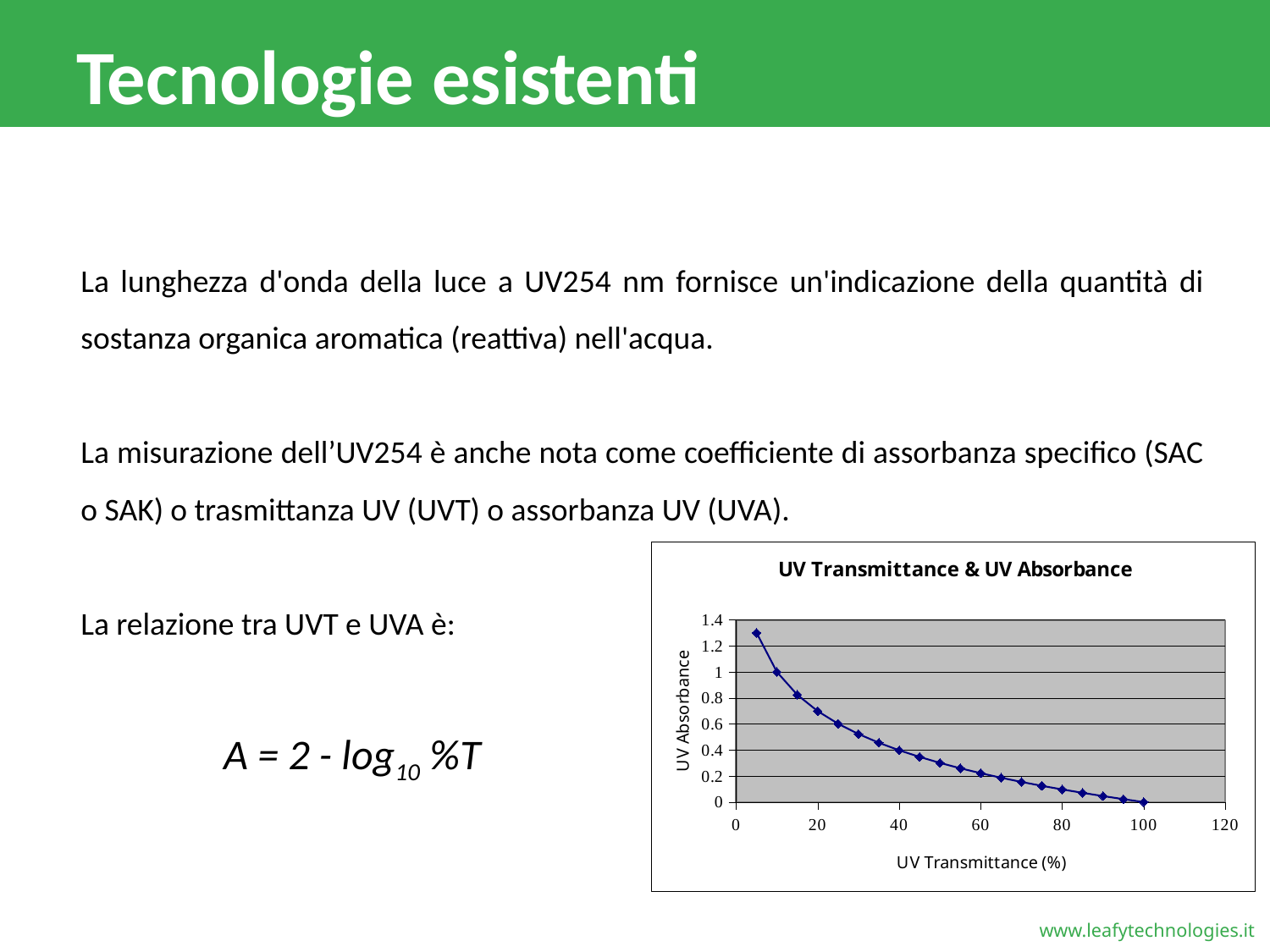
What is the UV Absorbance value at a UV Transmittance of 100%? 0 Which has the larger UV Absorbance: a UV Transmittance of 20% or 80%? 20% Is the UV Absorbance at a UV Transmittance of 20% greater or less than 0.6? greater Is the UV Absorbance at a UV Transmittance of 5% greater or less than 1.2? greater Is the UV Absorbance at a UV Transmittance of 60% greater or less than 0.4? less At which UV Transmittance value is the UV Absorbance highest? 5 What is the UV Absorbance value at a UV Transmittance of 10%? 1 What kind of chart is shown on the slide? line chart Does UV Absorbance rise or fall as UV Transmittance increases along the x axis? fall At which UV Transmittance value is the UV Absorbance lowest? 100 What is the title of the chart? UV Transmittance & UV Absorbance What is the label of the y axis of the chart? UV Absorbance